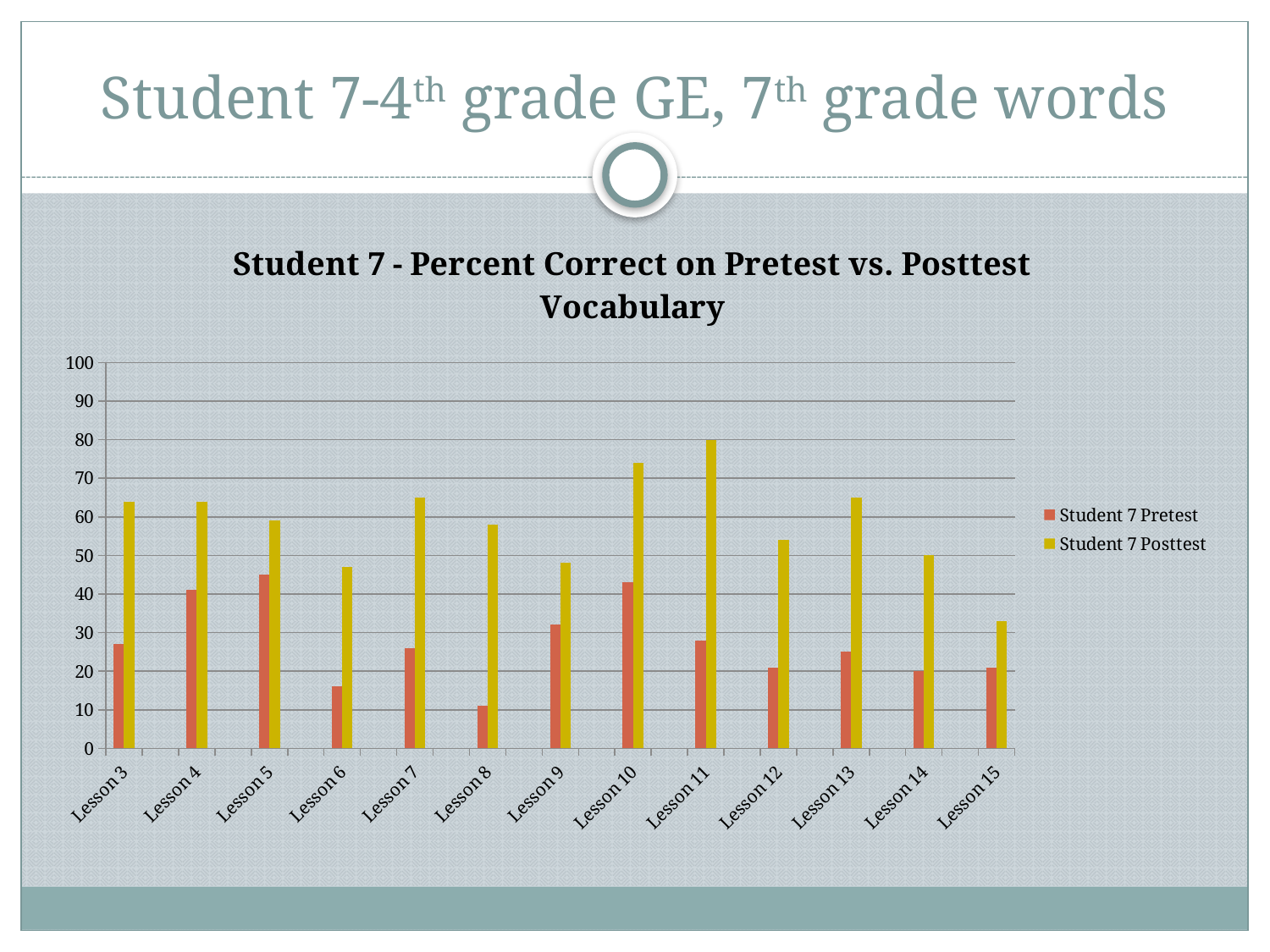
What is the Student 7 Posttest value for Lesson 11? 80 How many series does the legend list? 2 Which lesson has the lowest Student 7 Posttest value? Lesson 15 Which lesson has the highest Student 7 Posttest value? Lesson 11 Is the Student 7 Posttest value for Lesson 3 greater or less than 60? greater What is the title of the chart? Student 7 - Percent Correct on Pretest vs. Posttest Vocabulary How many lessons are shown on the x axis? 13 Which is larger, the Student 7 Posttest value for Lesson 11 or for Lesson 12? Lesson 11 Which lesson has the lowest Student 7 Pretest value? Lesson 8 What kind of chart is shown on the slide? bar chart Is the Student 7 Posttest value for Lesson 10 greater or less than 70? greater Is the Student 7 Pretest value for Lesson 6 greater or less than 20? less